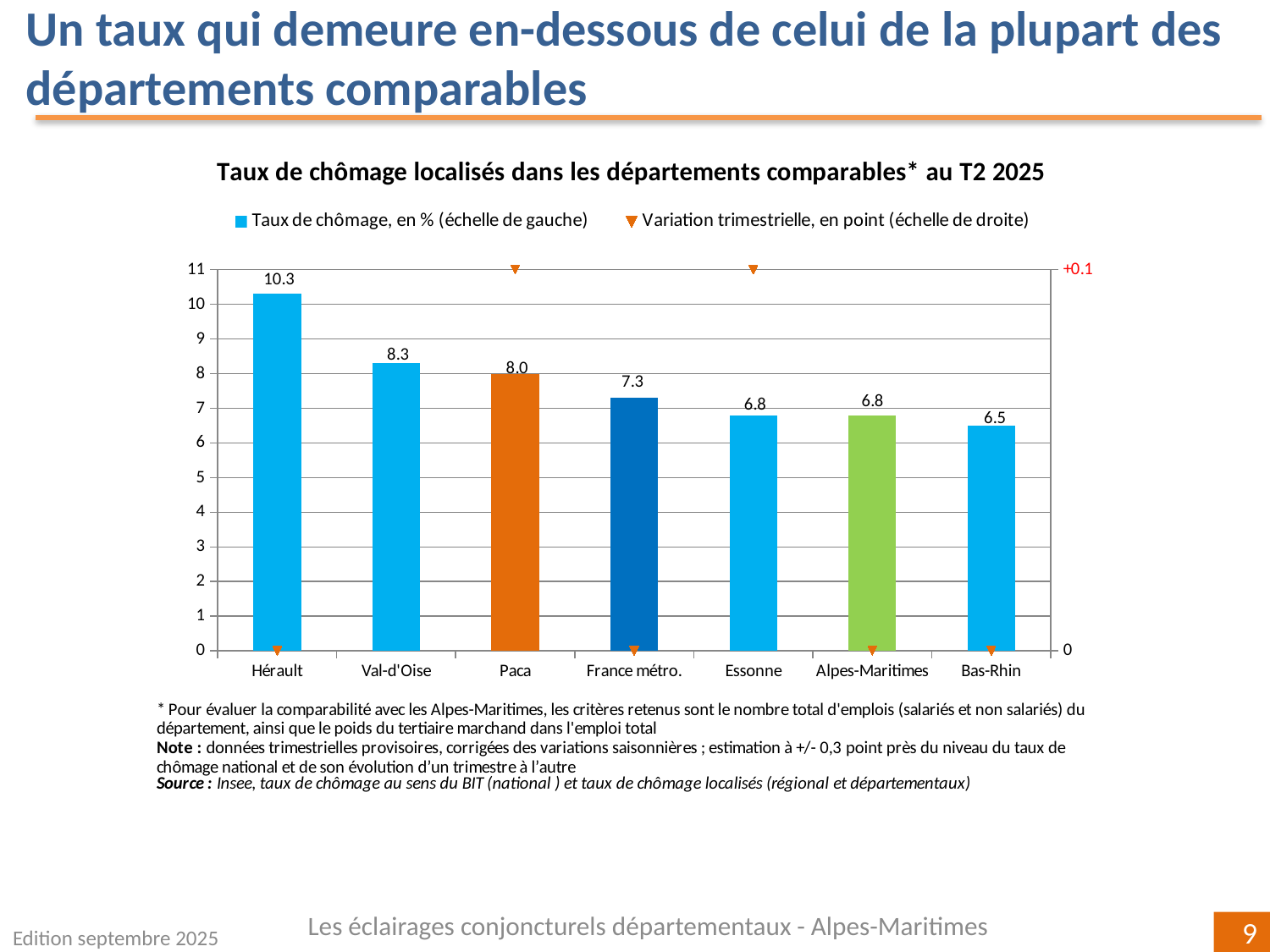
How many categories are shown on the x axis of the chart? 7 What is the quarterly variation (Variation trimestrielle) shown for Val-d'Oise on the right axis? +0.1 Which has a higher unemployment rate, Val-d'Oise or Paca? Val-d'Oise What is the difference between the unemployment rates of Hérault and Bas-Rhin? 3.8 Which category has the lowest unemployment rate? Bas-Rhin What is the title of the chart? Taux de chômage localisés dans les départements comparables* au T2 2025 Which category has the highest unemployment rate? Hérault What is the unemployment rate (Taux de chômage) shown for Hérault? 10.3 What kind of chart is used to show the unemployment rates? Bar chart What is the unemployment rate shown for Alpes-Maritimes? 6.8 How many series does the legend list? 2 What is the unemployment rate shown for France métro.? 7.3